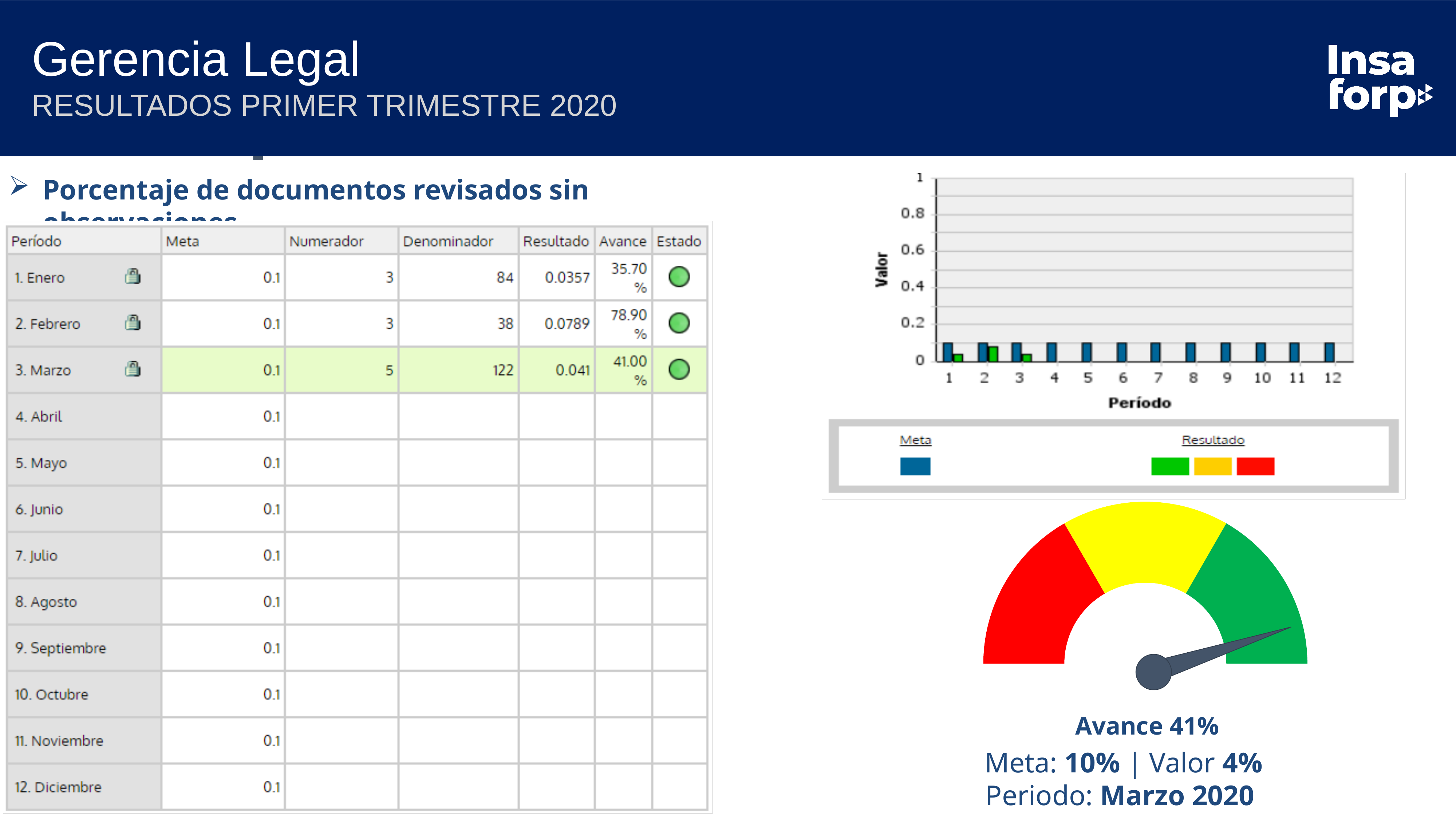
In the bar chart, which period has the highest Resultado bar? 2 What kind of chart is the chart with the Período axis at the top right of the slide? bar chart In the bar chart, is the Resultado bar for period 2 larger or smaller than the Resultado bar for period 3? larger In the bar chart, is the Resultado bar for period 2 larger or smaller than the Resultado bar for period 1? larger In the bar chart, what is the label of the vertical axis? Valor What Avance percentage is shown below the gauge chart? 41% In the bar chart at the top right, how many periods are shown on the Período axis? 12 In the bar chart, is the Meta value for period 5 greater or less than 0.2? less In the bar chart, is the Resultado value for period 2 greater or less than 0.2? less In the bar chart legend, what colour represents Meta? blue What Meta value is shown below the gauge chart? 10% How many series does the legend of the bar chart list? 2